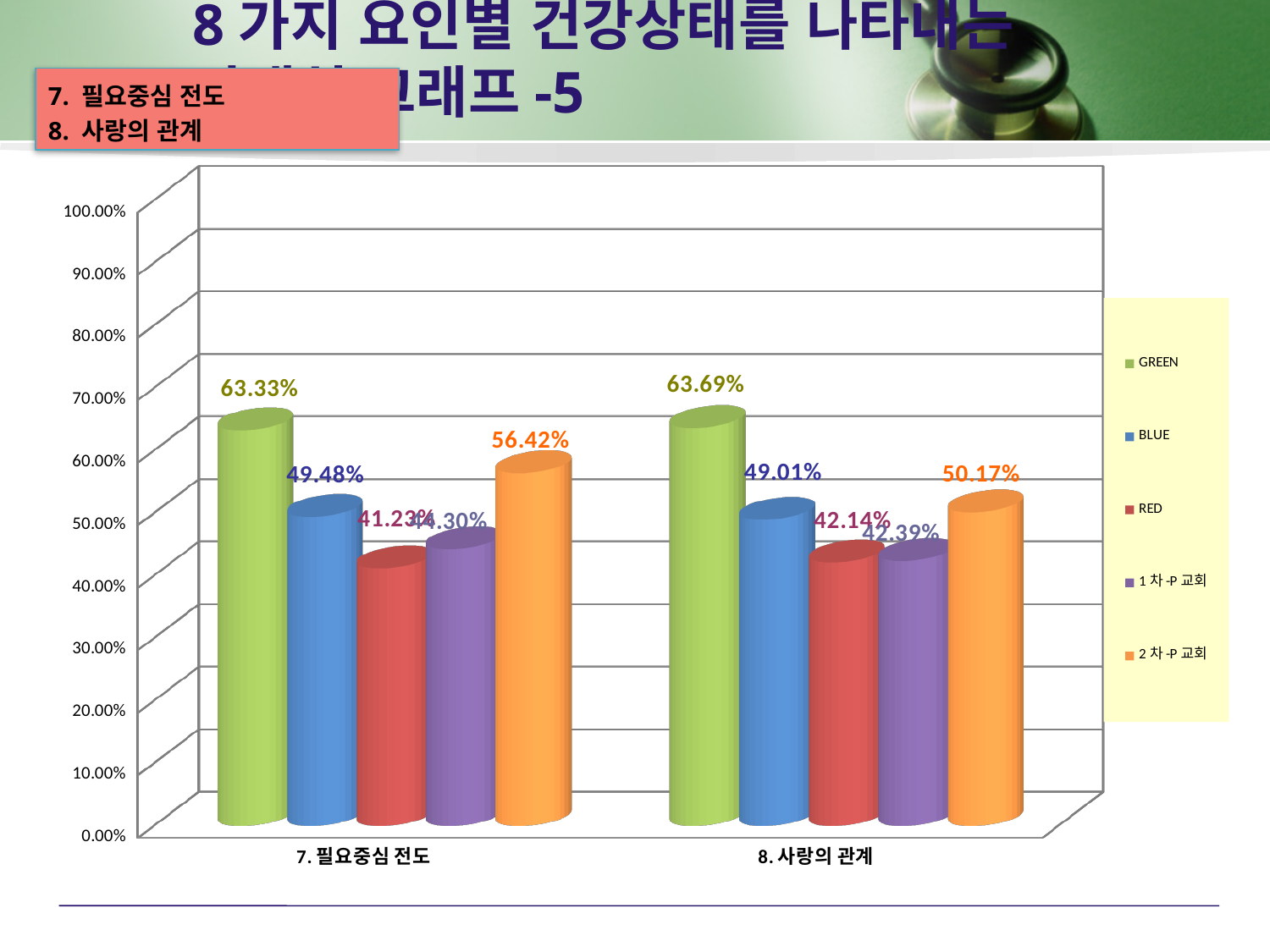
What is the value for 2 차-P 교회 in the category 8. 사랑의 관계? 50.17% What is the value for GREEN in the category 7. 필요중심 전도? 63.33% What kind of chart is shown on the slide? bar chart Is the BLUE value larger for 7. 필요중심 전도 or for 8. 사랑의 관계? 7. 필요중심 전도 What is the difference between the GREEN values for 8. 사랑의 관계 and 7. 필요중심 전도? 0.36% How many categories are shown on the x axis? 2 How many series does the legend list? 5 What is the difference between the 2 차-P 교회 values for 7. 필요중심 전도 and 8. 사랑의 관계? 6.25% What is the value for BLUE in the category 8. 사랑의 관계? 49.01% Which series has the lowest value in the category 7. 필요중심 전도? RED Which series has the highest value in the category 8. 사랑의 관계? GREEN Is the value for RED in 8. 사랑의 관계 greater or less than 50.00%? less